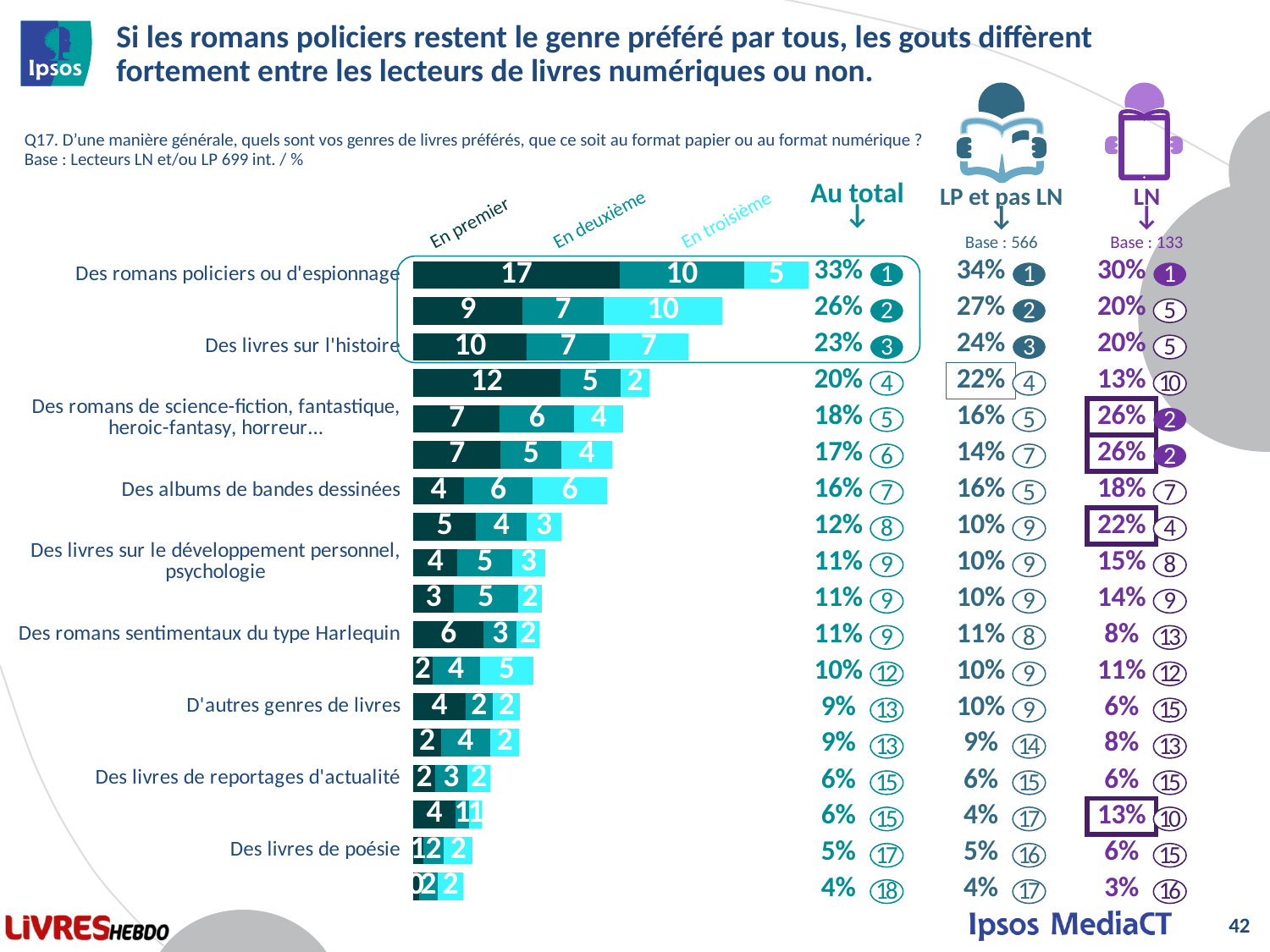
What is the 'En deuxième' value for 'Des albums de bandes dessinées'? 6 How many series does the chart legend list (En premier, En deuxième, En troisième)? 3 Which genre has the highest 'Au total' percentage? Des romans policiers ou d'espionnage What is the 'LN' percentage for 'Des romans de science-fiction, fantastique, heroic-fantasy, horreur…'? 26% What kind of chart is shown on the slide? Stacked bar chart What is the 'En troisième' value for 'Des livres sur l'histoire'? 7 What is the difference between the 'En premier' values for 'Des romans policiers ou d'espionnage' and 'Des livres sur l'histoire'? 7 What is the 'Au total' percentage for 'Des romans de science-fiction, fantastique, heroic-fantasy, horreur…'? 18% What is the 'En premier' value for 'Des romans policiers ou d'espionnage'? 17 How many bars (book genres) are plotted in the chart? 18 Which is larger: the 'En premier' value for 'Des albums de bandes dessinées' or for 'Des romans sentimentaux du type Harlequin'? Des romans sentimentaux du type Harlequin What is the total of the stacked bar for 'Des romans sentimentaux du type Harlequin'? 11